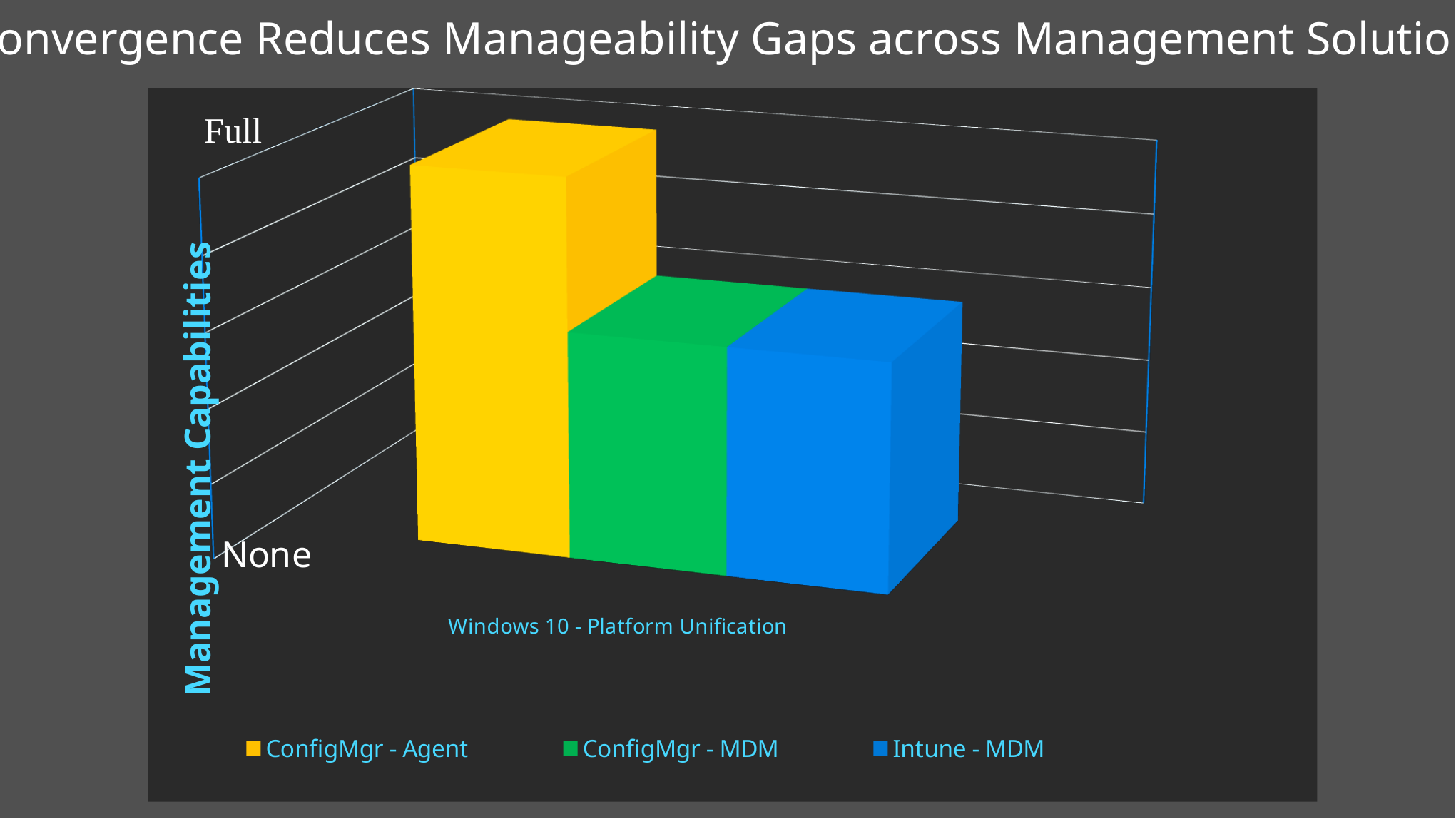
What is the title of the vertical axis? Management Capabilities Which is larger, the bar for ConfigMgr - MDM or the bar for ConfigMgr - Agent? ConfigMgr - Agent What kind of chart is shown on the slide? Bar chart How many categories are plotted on the x axis? 1 Which series has the highest bar? ConfigMgr - Agent Which is larger, the bar for ConfigMgr - Agent or the bar for Intune - MDM? ConfigMgr - Agent What is the label of the category on the x axis? Windows 10 - Platform Unification How many series does the legend list? 3